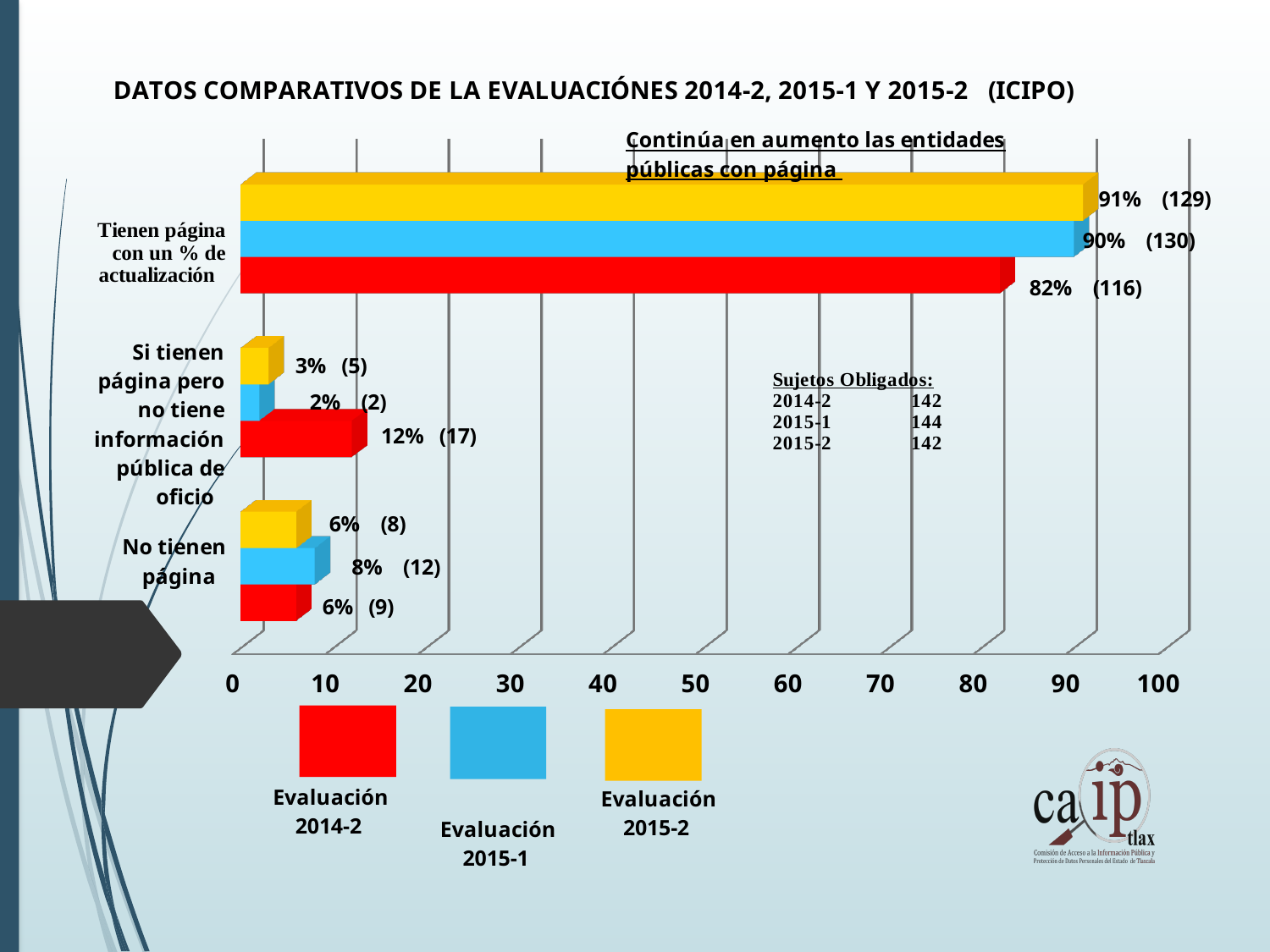
What is the percentage for 'Tienen página con un % de actualización' in Evaluación 2014-2? 82% What kind of chart is shown on the slide? Bar chart How many categories are shown on the chart? 3 Which evaluation has the highest percentage for 'Tienen página con un % de actualización'? Evaluación 2015-2 Which evaluation has the lowest percentage for 'Si tienen página pero no tiene información pública de oficio'? Evaluación 2015-1 For 'No tienen página', which is larger: Evaluación 2015-1 or Evaluación 2015-2? Evaluación 2015-1 What is the difference in percentage points between Evaluación 2015-2 and Evaluación 2014-2 for 'Tienen página con un % de actualización'? 9 What is the percentage for 'No tienen página' in Evaluación 2015-1? 8% What is the percentage for 'Si tienen página pero no tiene información pública de oficio' in Evaluación 2014-2? 12% What is the percentage for 'Tienen página con un % de actualización' in Evaluación 2015-2? 91% How many series does the legend list? 3 Which colour represents Evaluación 2014-2 in the legend? Red